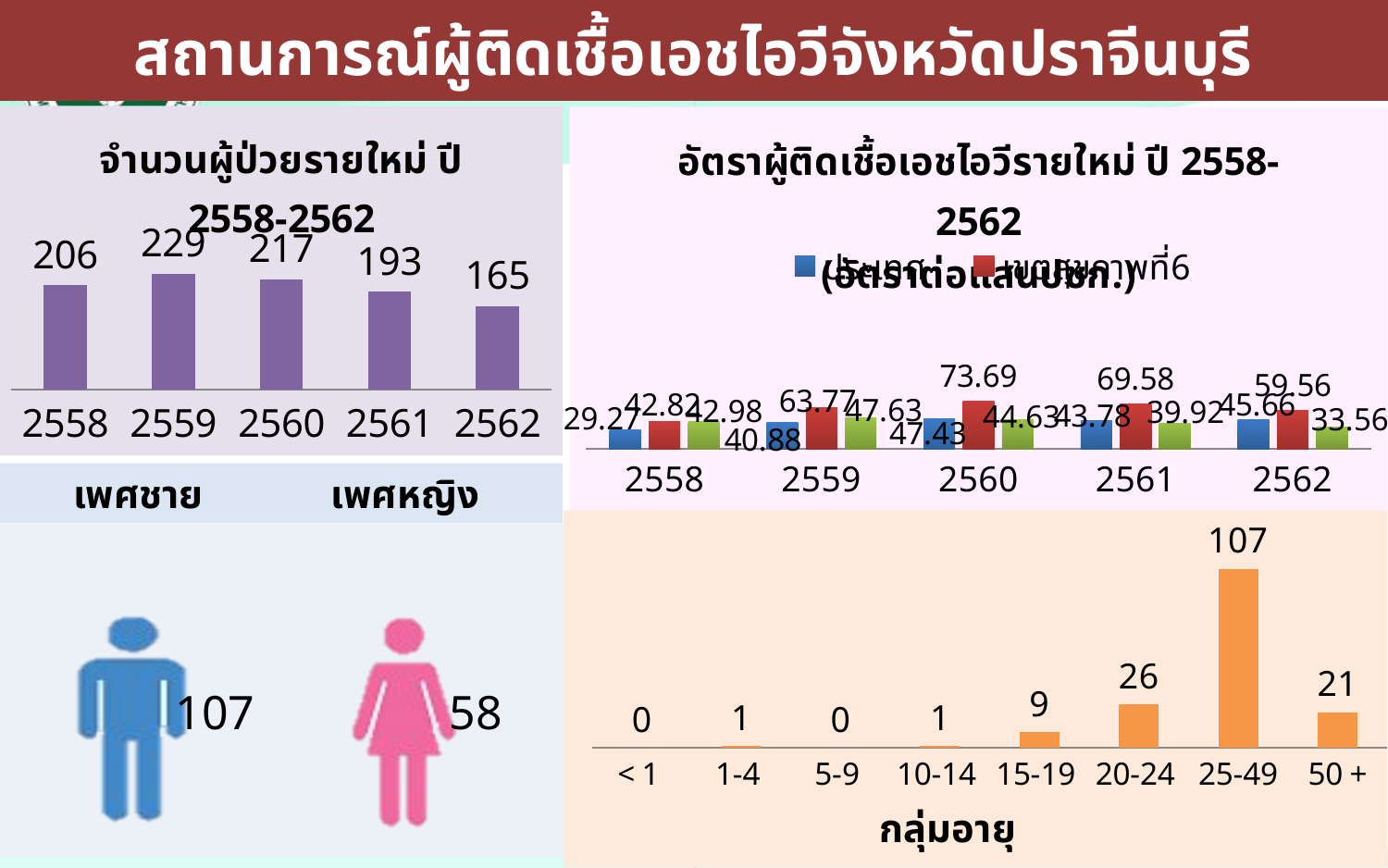
In the top-left chart (จำนวนผู้ป่วยรายใหม่ ปี 2558-2562), do the values rise or fall from 2559 to 2562? fall In the top-left chart (จำนวนผู้ป่วยรายใหม่ ปี 2558-2562), what is the value for 2559? 229 In the top-left chart (จำนวนผู้ป่วยรายใหม่ ปี 2558-2562), which year has the lowest value? 2562 In the top-left chart (จำนวนผู้ป่วยรายใหม่ ปี 2558-2562), how many years are shown on the x axis? 5 In the bottom-right chart (กลุ่มอายุ), what is the difference between the values for 20-24 and 50 +? 5 In the bottom-right chart (กลุ่มอายุ), which age group has the highest value? 25-49 In the top-right chart (อัตราผู้ติดเชื้อเอชไอวีรายใหม่ ปี 2558-2562), which year has the highest red bar? 2560 In the top-left chart (จำนวนผู้ป่วยรายใหม่ ปี 2558-2562), which year has the highest value? 2559 In the top-right chart (อัตราผู้ติดเชื้อเอชไอวีรายใหม่ ปี 2558-2562), what is the value of the blue bar for 2558? 29.27 In the bottom-right chart (กลุ่มอายุ), what is the value for the 25-49 age group? 107 In the top-left chart (จำนวนผู้ป่วยรายใหม่ ปี 2558-2562), what is the difference between the values for 2558 and 2562? 41 In the top-right chart (อัตราผู้ติดเชื้อเอชไอวีรายใหม่ ปี 2558-2562), what is the value of the red bar for 2560? 73.69